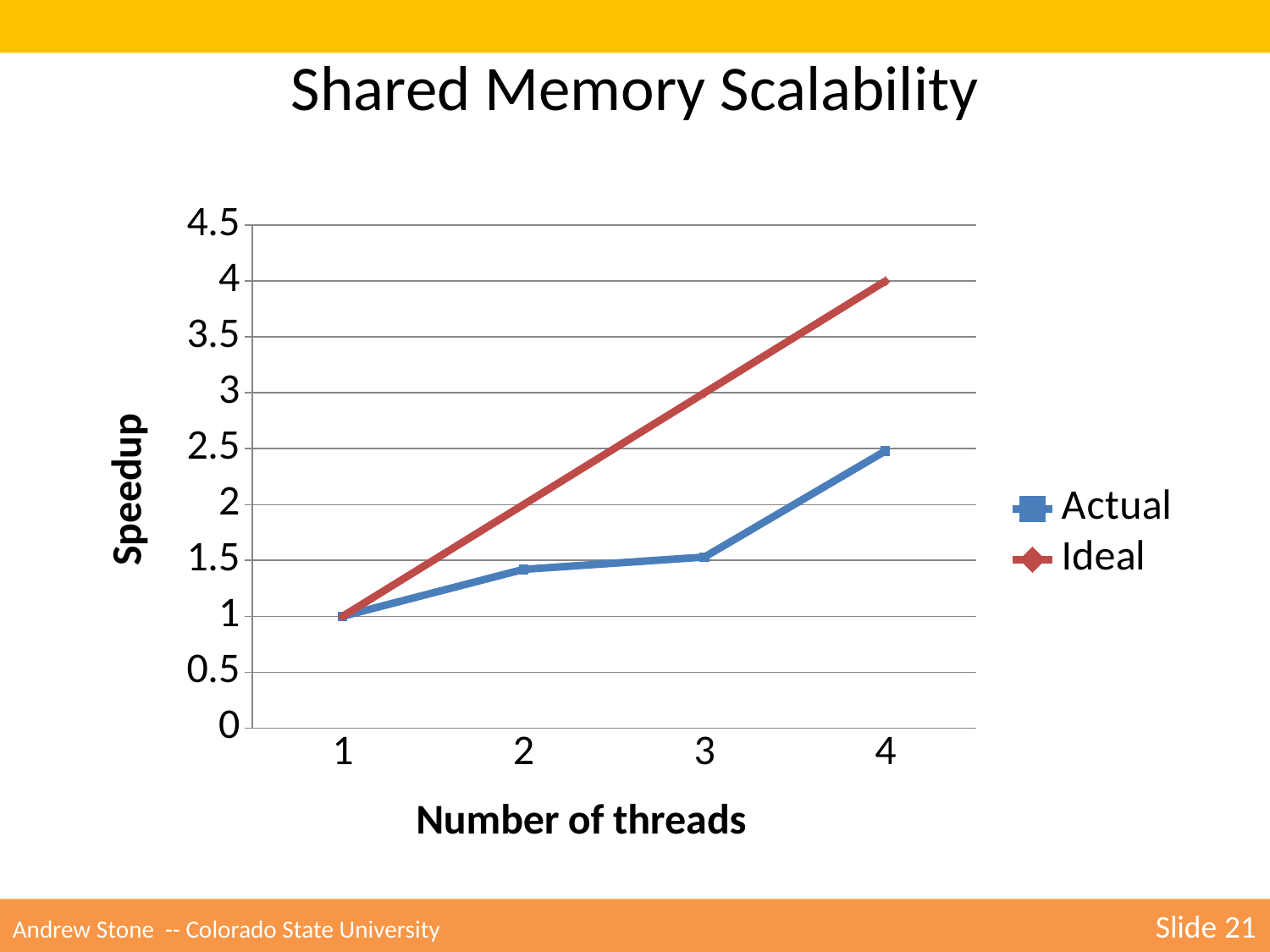
What is the difference between the Ideal speedup at 4 threads and at 1 thread? 3 What is the Ideal speedup at 4 threads? 4 What type of chart is shown on the slide? line chart Is the Actual speedup at 4 threads greater or less than 2? greater At 4 threads, which series has the larger speedup, Actual or Ideal? Ideal How many series does the legend list? 2 What is the Ideal speedup at 2 threads? 2 Does the Actual speedup rise or fall as the number of threads increases? rise How many thread counts are plotted along the x axis? 4 What is the Actual speedup at 1 thread? 1 What is the label of the y axis? Speedup Is the Actual speedup at 3 threads greater or less than 2? less